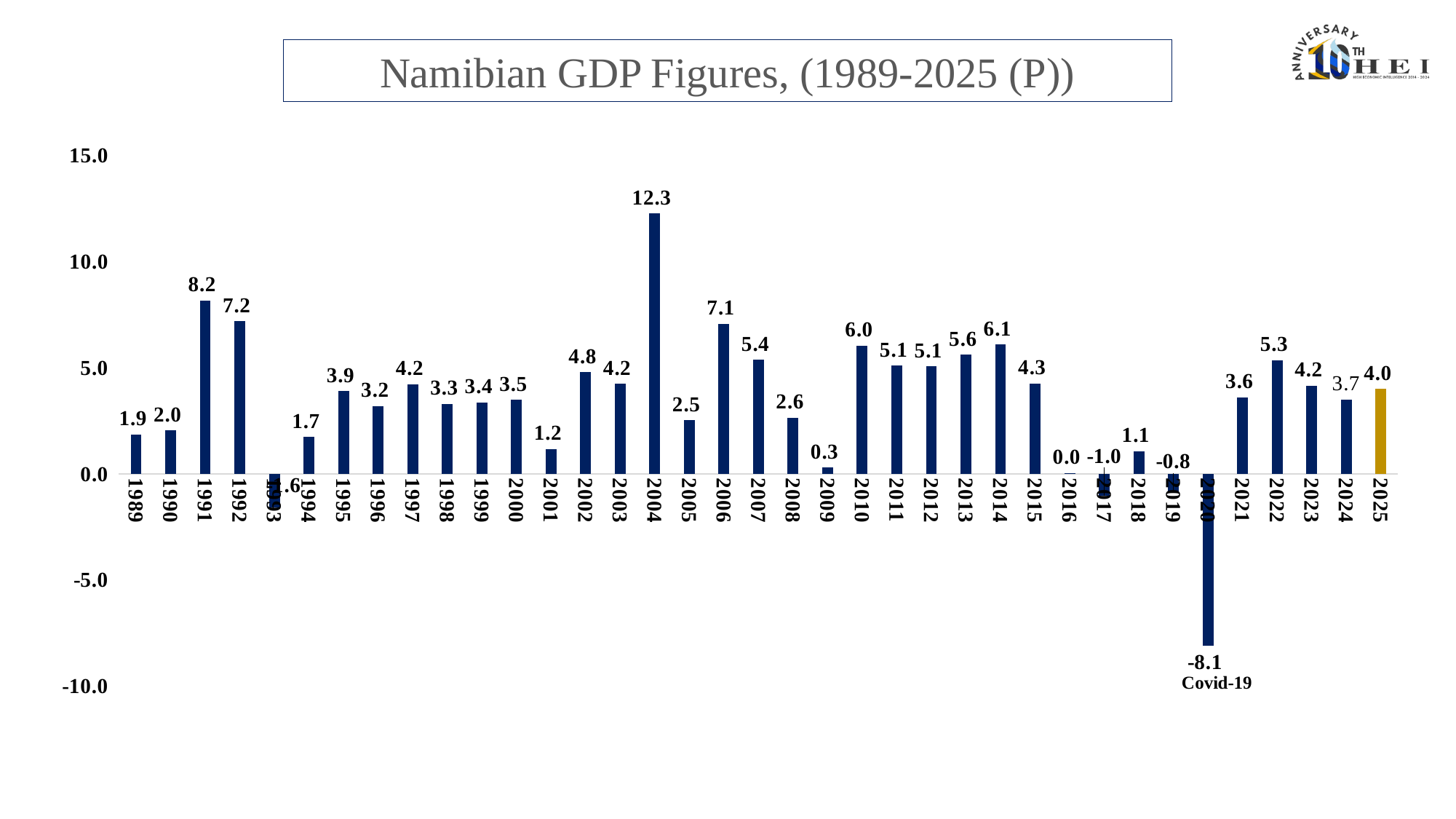
Which year has the highest GDP figure on the chart? 2004 What is the GDP figure shown for 2020? -8.1 Which year has the larger GDP figure, 2006 or 2007? 2006 What is the difference between the GDP figures for 1991 and 1992? 1.0 Is the value for 2004 greater or less than 10.0? greater What kind of chart is shown on the slide? Bar chart What is the GDP figure shown for 2004? 12.3 What annotation is written beneath the 2020 bar? Covid-19 What is the GDP figure shown for 2025? 4.0 How many years are plotted on the chart? 37 Which year has the lowest GDP figure on the chart? 2020